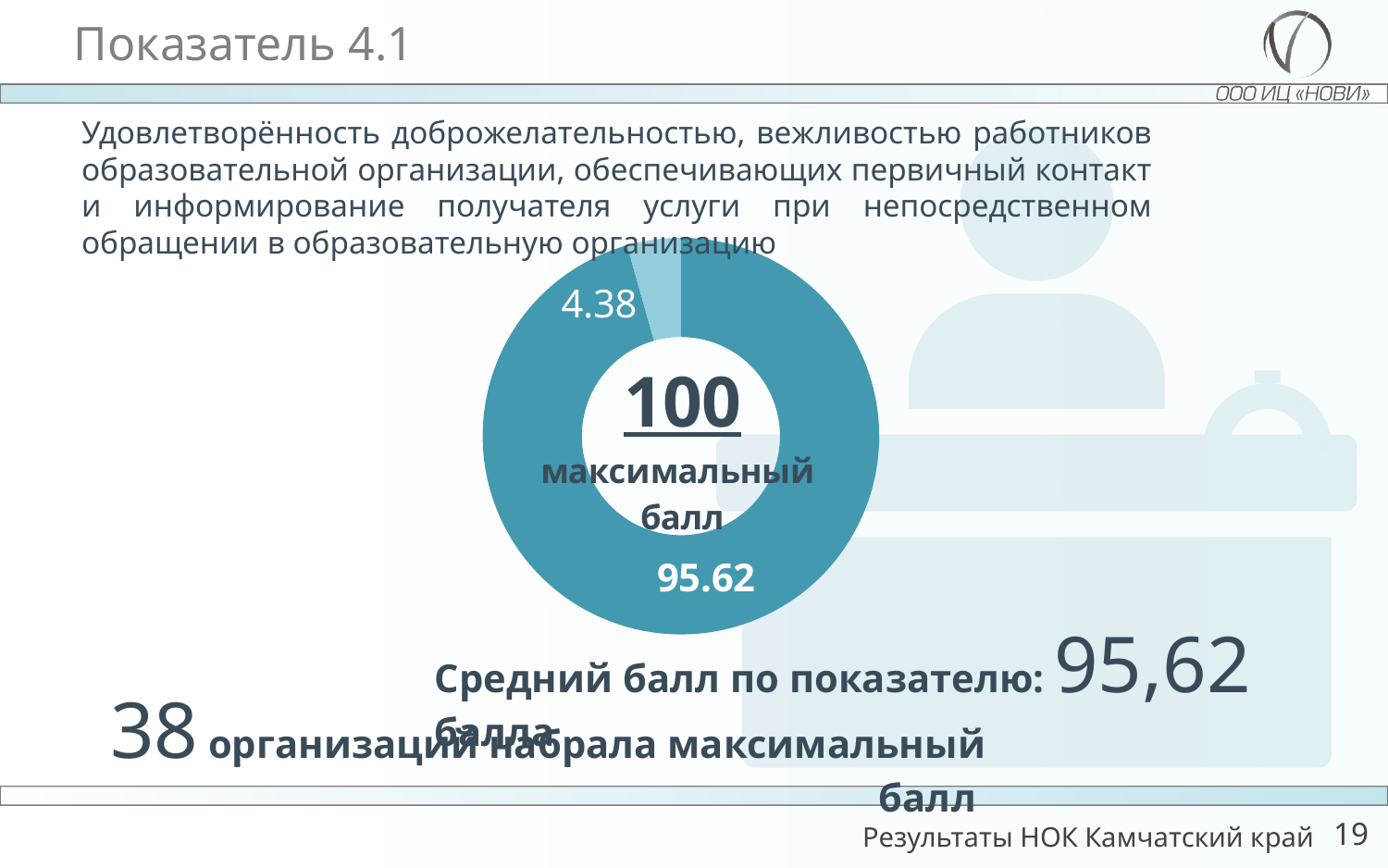
What kind of chart is shown on the slide? Donut (pie) chart What value is printed on the small light slice of the donut chart? 4.38 What text accompanies the number in the centre of the donut chart? максимальный балл Which slice of the donut chart is the largest? 95.62 Which slice of the donut chart is the smallest? 4.38 What number is printed in the centre of the donut chart? 100 What value is printed on the large dark teal slice of the donut chart? 95.62 Which is larger in the donut chart: the dark teal slice or the light slice? The dark teal slice (95.62) What is the total of the two slice values in the donut chart? 100 What is the difference between the two slice values in the donut chart? 91.24 Is the value of the large slice greater or less than 90? greater How many slices does the donut chart have? 2